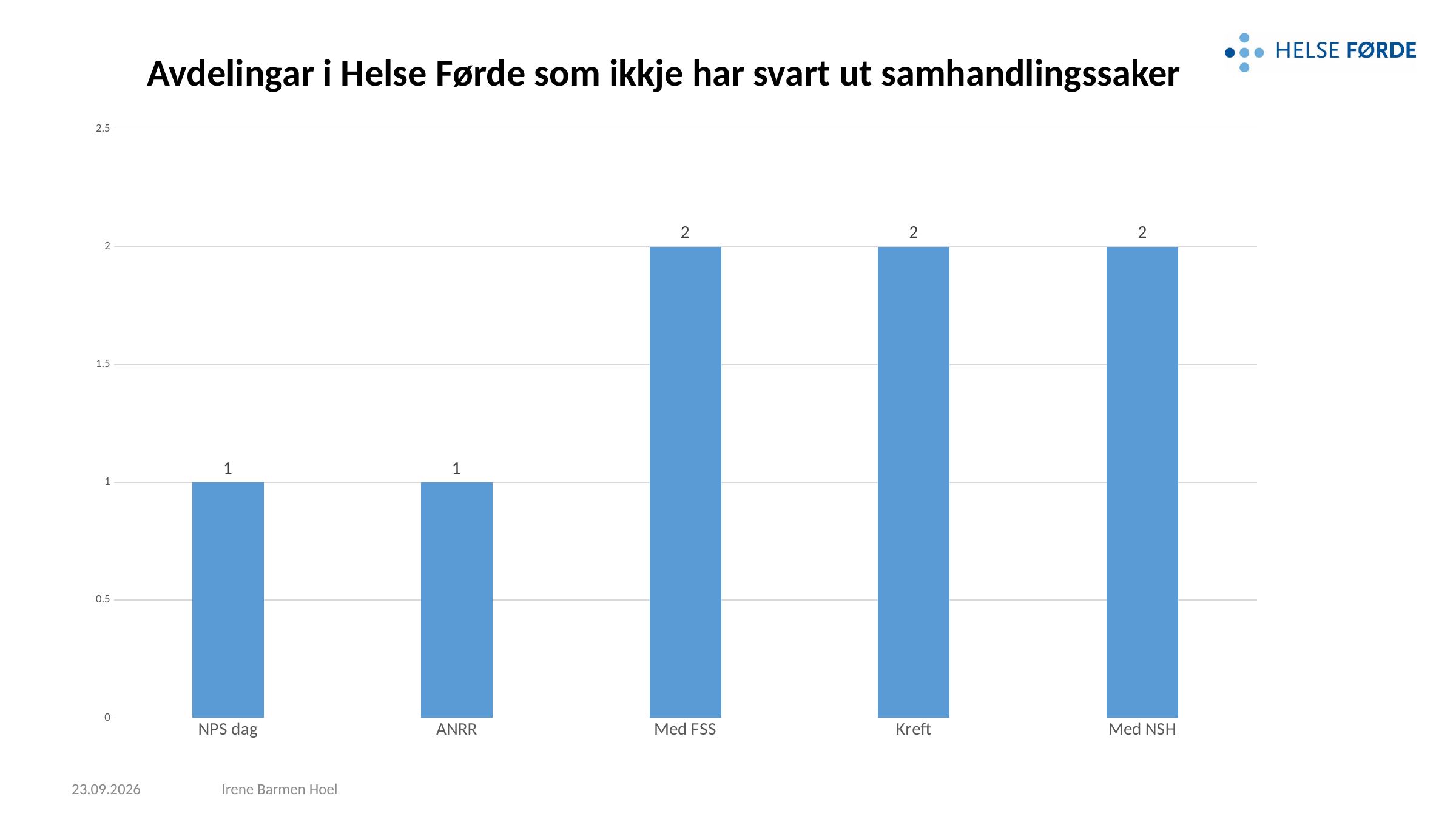
What is the title of the chart? Avdelingar i Helse Førde som ikkje har svart ut samhandlingssaker What is the value for Med NSH? 2 How many categories are shown on the x axis? 5 What is the difference between the values for Med FSS and NPS dag? 1 What is the value for ANRR? 1 What is the value for Med FSS? 2 Which is larger, the value for Kreft or the value for ANRR? Kreft Is the value for Med NSH greater or less than 1.5? greater Is the value for NPS dag greater or less than 1.5? less What kind of chart is shown on the slide? bar chart What is the value for NPS dag? 1 What is the value for Kreft? 2